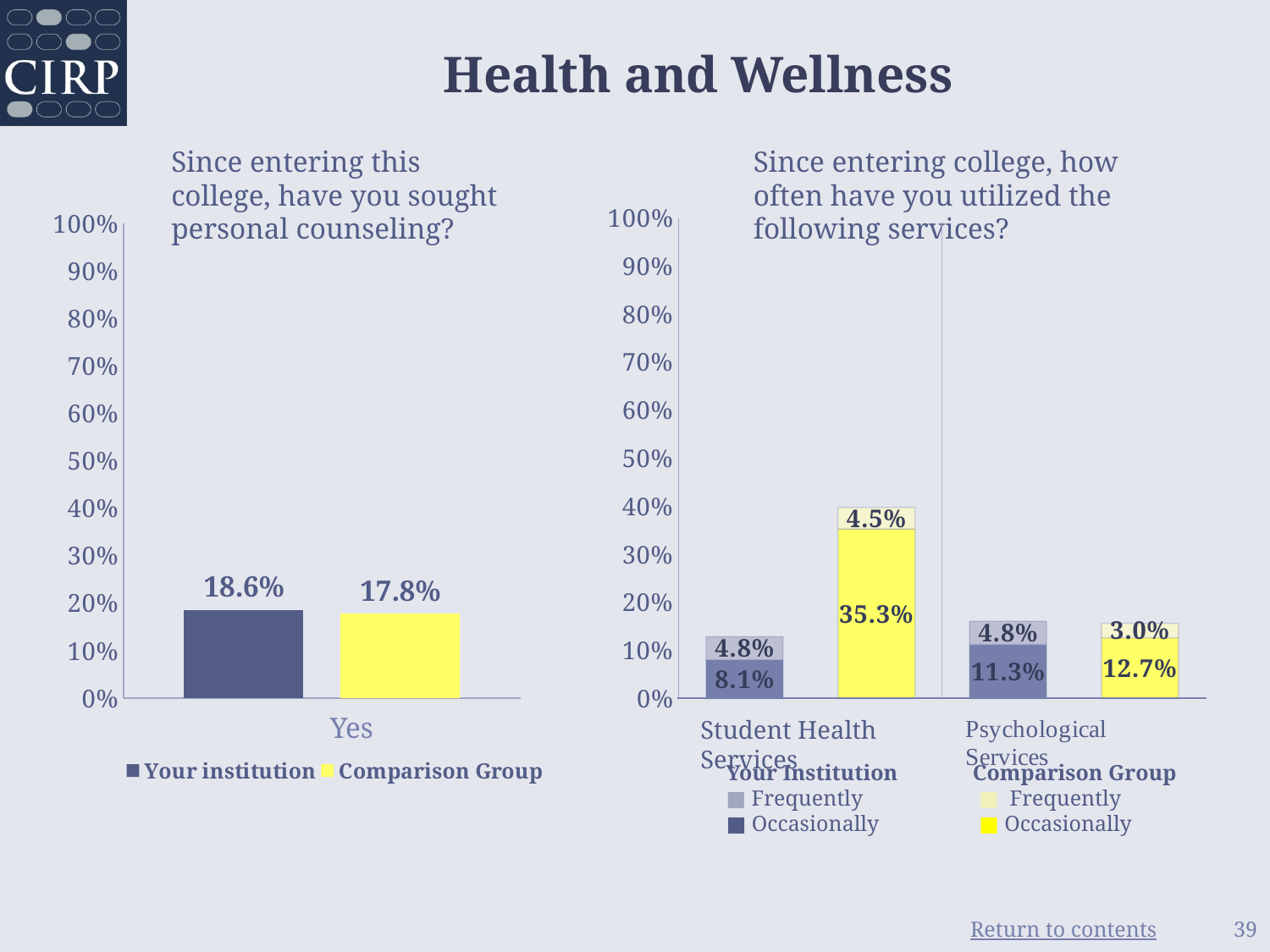
What kind of chart is the right chart on utilization of services? Stacked bar chart In the left chart on personal counseling, what is the value for the Comparison Group? 17.8% In the right chart on utilization of services, what is the total of the Comparison Group bar for Student Health Services? 39.8% In the left chart on personal counseling, what is the difference between Your institution and the Comparison Group? 0.8% In the right chart on utilization of services, how many service categories are shown on the x axis? 2 In the right chart on utilization of services, what is the Occasionally value for the Comparison Group for Student Health Services? 35.3% In the left chart on personal counseling, how many series does the legend list? 2 In the left chart on personal counseling, which is larger, Your institution or the Comparison Group? Your institution In the right chart on utilization of services, what is the total of the Your Institution bar for Psychological Services? 16.1% In the right chart on utilization of services, which bar is the tallest? Comparison Group for Student Health Services In the left chart on personal counseling, what is the value for Your institution? 18.6% In the right chart on utilization of services, what is the Frequently value for Your Institution for Psychological Services? 4.8%